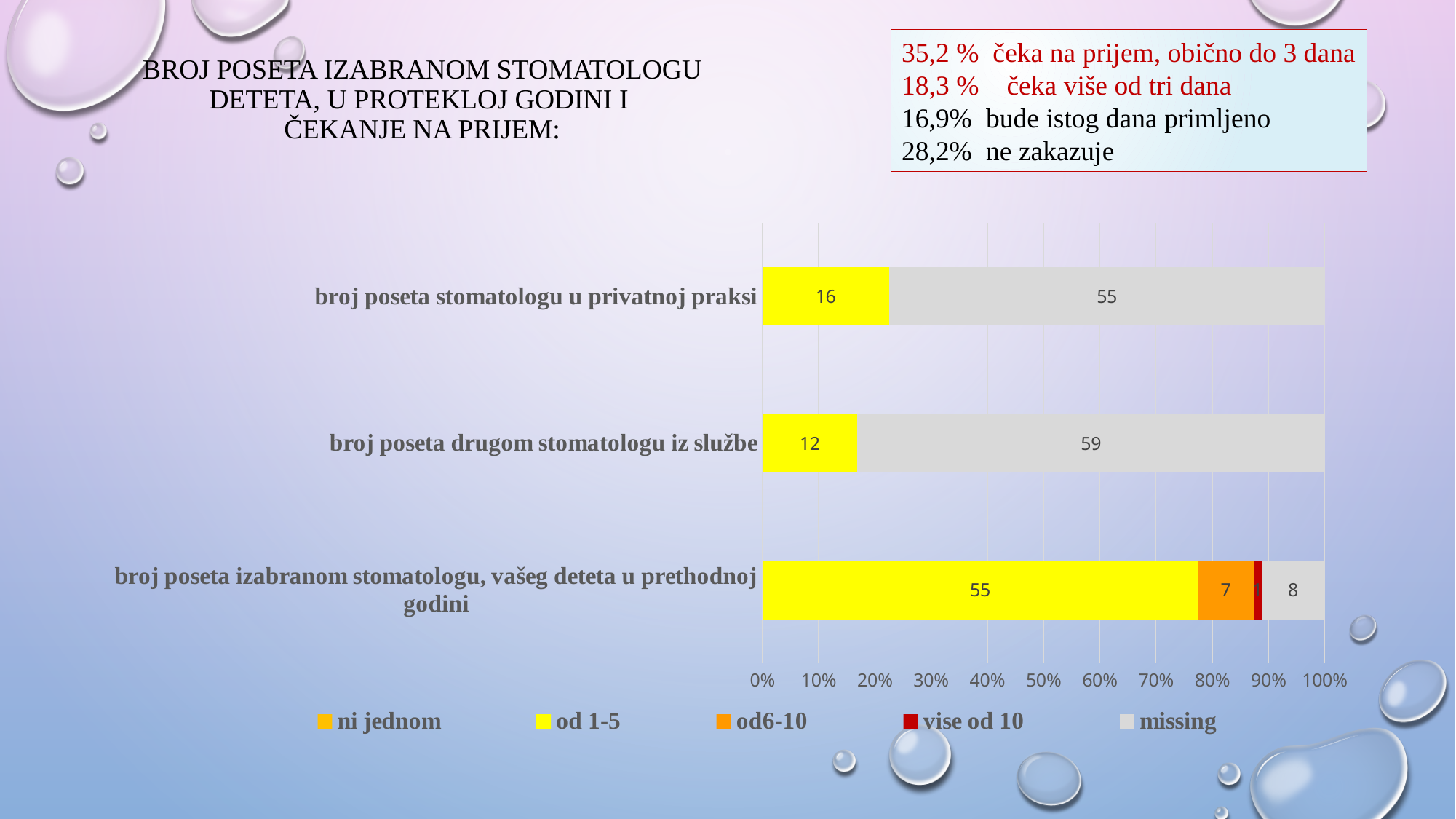
What is the difference between the 'missing' values for 'broj poseta drugom stomatologu iz službe' and 'broj poseta stomatologu u privatnoj praksi'? 4 What is the 'vise od 10' value for 'broj poseta izabranom stomatologu, vašeg deteta u prethodnoj godini'? 1 What is the 'od6-10' value for 'broj poseta izabranom stomatologu, vašeg deteta u prethodnoj godini'? 7 Which colour represents the 'missing' series in the legend? grey Which category has the highest 'od 1-5' value? broj poseta izabranom stomatologu, vašeg deteta u prethodnoj godini What is the 'missing' value for 'broj poseta drugom stomatologu iz službe'? 59 What is the total of the stacked bar for 'broj poseta izabranom stomatologu, vašeg deteta u prethodnoj godini'? 71 How many categories are plotted on the chart? 3 Which category has the lowest 'missing' value? broj poseta izabranom stomatologu, vašeg deteta u prethodnoj godini What is the 'od 1-5' value for 'broj poseta stomatologu u privatnoj praksi'? 16 How many series does the chart legend list? 5 What kind of chart is shown on the slide? bar chart